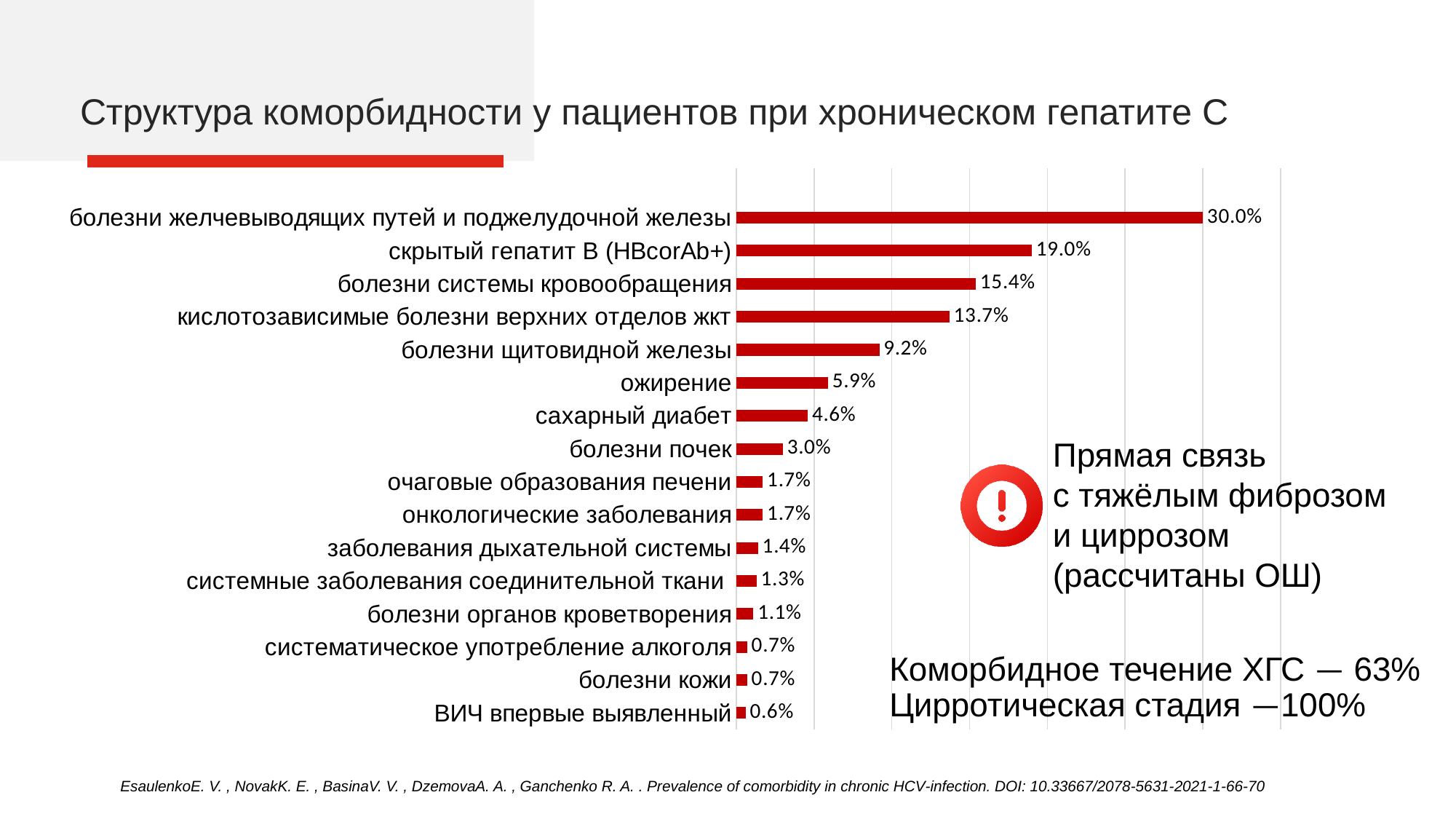
Which category has the lowest value? ВИЧ впервые выявленный What is the difference between the values for «болезни желчевыводящих путей и поджелудочной железы» and «скрытый гепатит B (HBcorAb+)»? 11.0% Which category has the highest value? болезни желчевыводящих путей и поджелудочной железы How many categories are shown in the chart? 16 What is the value for «сахарный диабет»? 4.6% What is the difference between the values for «болезни щитовидной железы» and «ожирение»? 3.3% What is the value for «болезни желчевыводящих путей и поджелудочной железы»? 30.0% Do the values increase or decrease going from the top category to the bottom category? decrease What is the value for «скрытый гепатит B (HBcorAb+)»? 19.0% What is the value for «ожирение»? 5.9% What kind of chart is shown on the slide? bar chart Which is larger: the value for «болезни системы кровообращения» or for «кислотозависимые болезни верхних отделов жкт»? болезни системы кровообращения